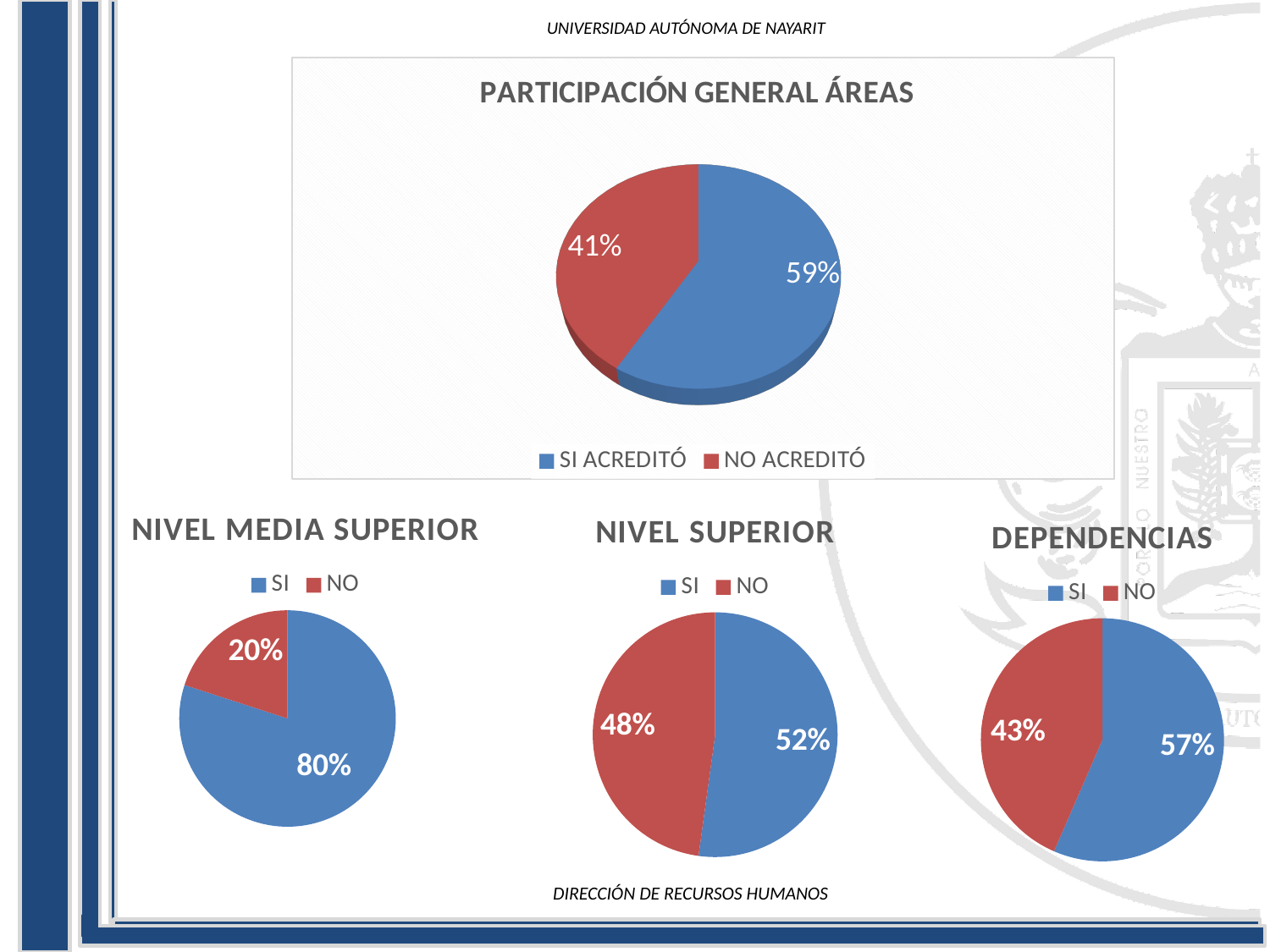
In the 'PARTICIPACIÓN GENERAL ÁREAS' chart, what share is labelled for NO ACREDITÓ? 41% What kind of chart is the 'PARTICIPACIÓN GENERAL ÁREAS' chart? Pie chart In the 'PARTICIPACIÓN GENERAL ÁREAS' chart, what share is labelled for SI ACREDITÓ? 59% In the 'NIVEL MEDIA SUPERIOR' chart, what share is labelled for SI? 80% In the 'DEPENDENCIAS' chart, which slice is larger, SI or NO? SI In the 'NIVEL SUPERIOR' chart, what is the difference between the SI and NO shares? 4% In the 'NIVEL SUPERIOR' chart, what colour is the SI slice? Blue In the 'NIVEL MEDIA SUPERIOR' chart, what is the difference between the SI and NO shares? 60% In the 'DEPENDENCIAS' chart, what share is labelled for SI? 57% In the 'NIVEL MEDIA SUPERIOR' chart, what share is labelled for NO? 20% In the 'NIVEL SUPERIOR' chart, what share is labelled for NO? 48% How many series does the legend of the 'PARTICIPACIÓN GENERAL ÁREAS' chart list? 2